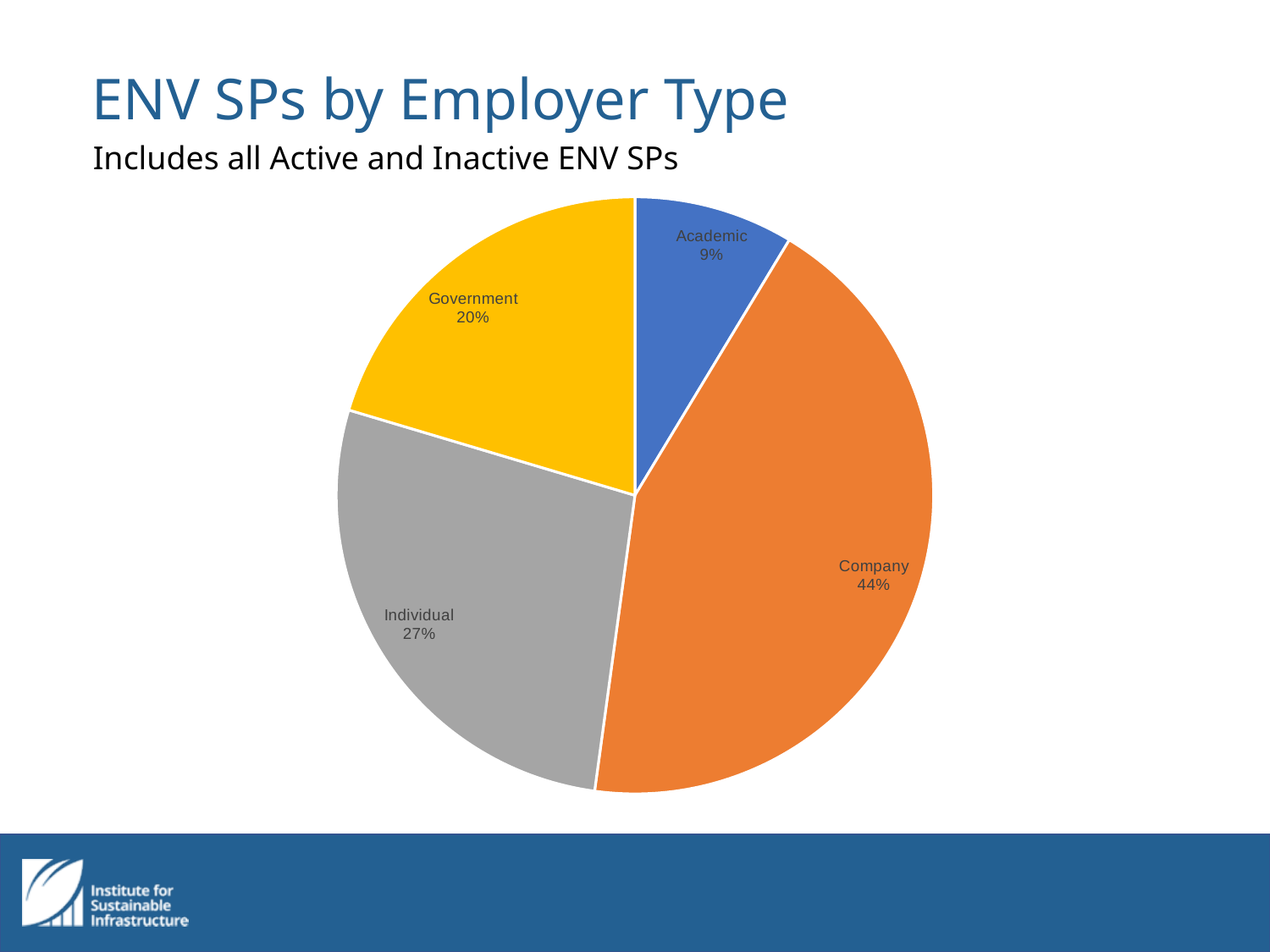
What share of ENV SPs are in the Individual category? 27% What kind of chart is shown on the slide? Pie chart Which employer type has the largest share of ENV SPs? Company How many percentage points larger is the Government share than the Academic share? 11 How many percentage points larger is the Company share than the Individual share? 17 Which employer type has the smallest share of ENV SPs? Academic What is the title of the chart on the slide? ENV SPs by Employer Type What share of ENV SPs are employed by a Company? 44% What share of ENV SPs are in the Government category? 20% What share of ENV SPs are in the Academic category? 9% How many employer type categories are shown in the pie chart? 4 Which is larger, the Individual share or the Government share? Individual